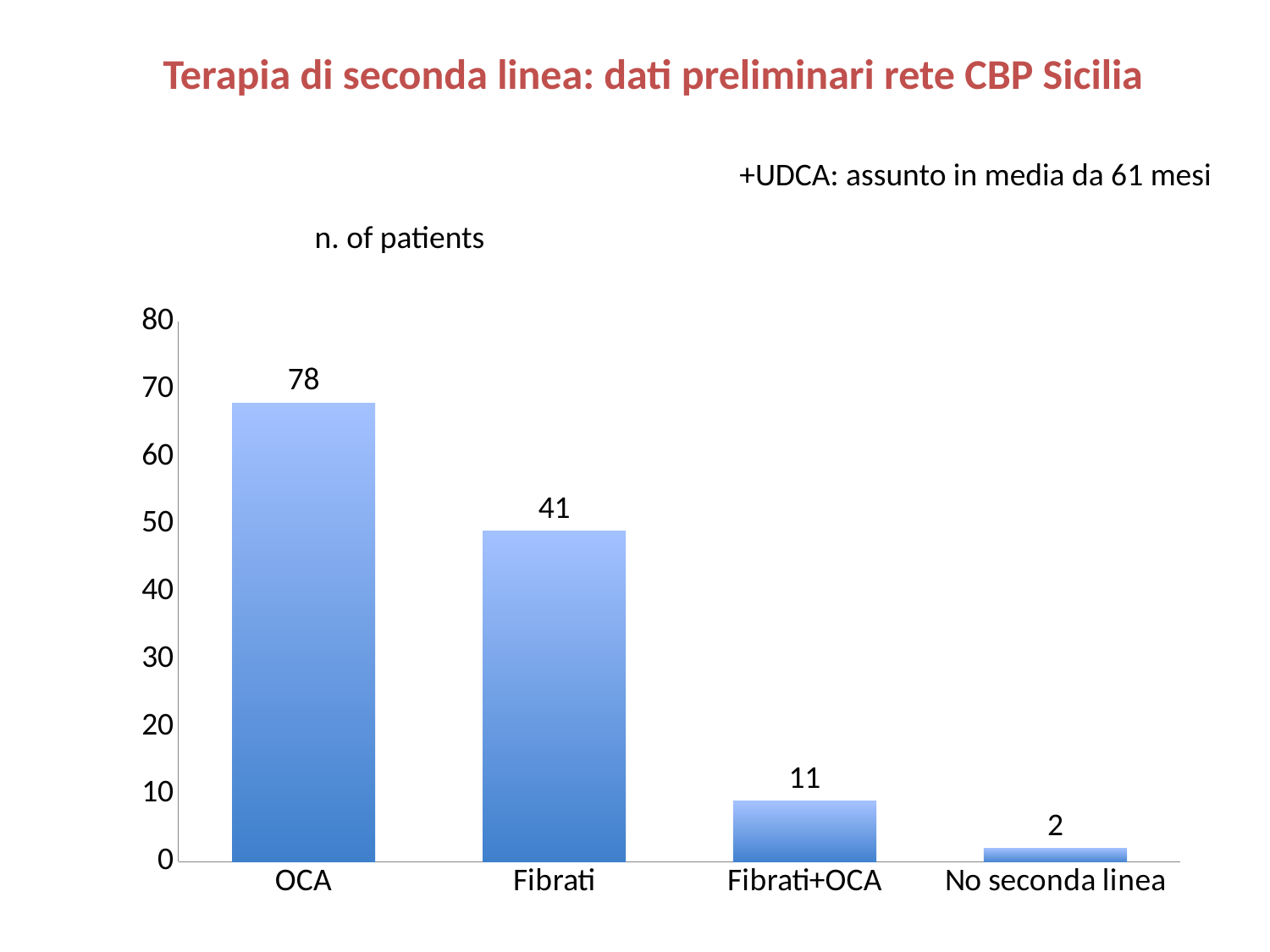
What is the value for Fibrati+OCA? 11 Which category has the highest value? OCA What is the value for No seconda linea? 2 What is the value for Fibrati? 41 What is the difference between the values for OCA and Fibrati? 37 How many categories are shown on the x axis? 4 Is the value for Fibrati greater or less than 60? less What is the value for OCA? 78 Which category has the lowest value? No seconda linea What is the label shown above the chart describing the plotted quantity? n. of patients What kind of chart is shown on the slide? bar chart Which is larger, the value for Fibrati or the value for Fibrati+OCA? Fibrati